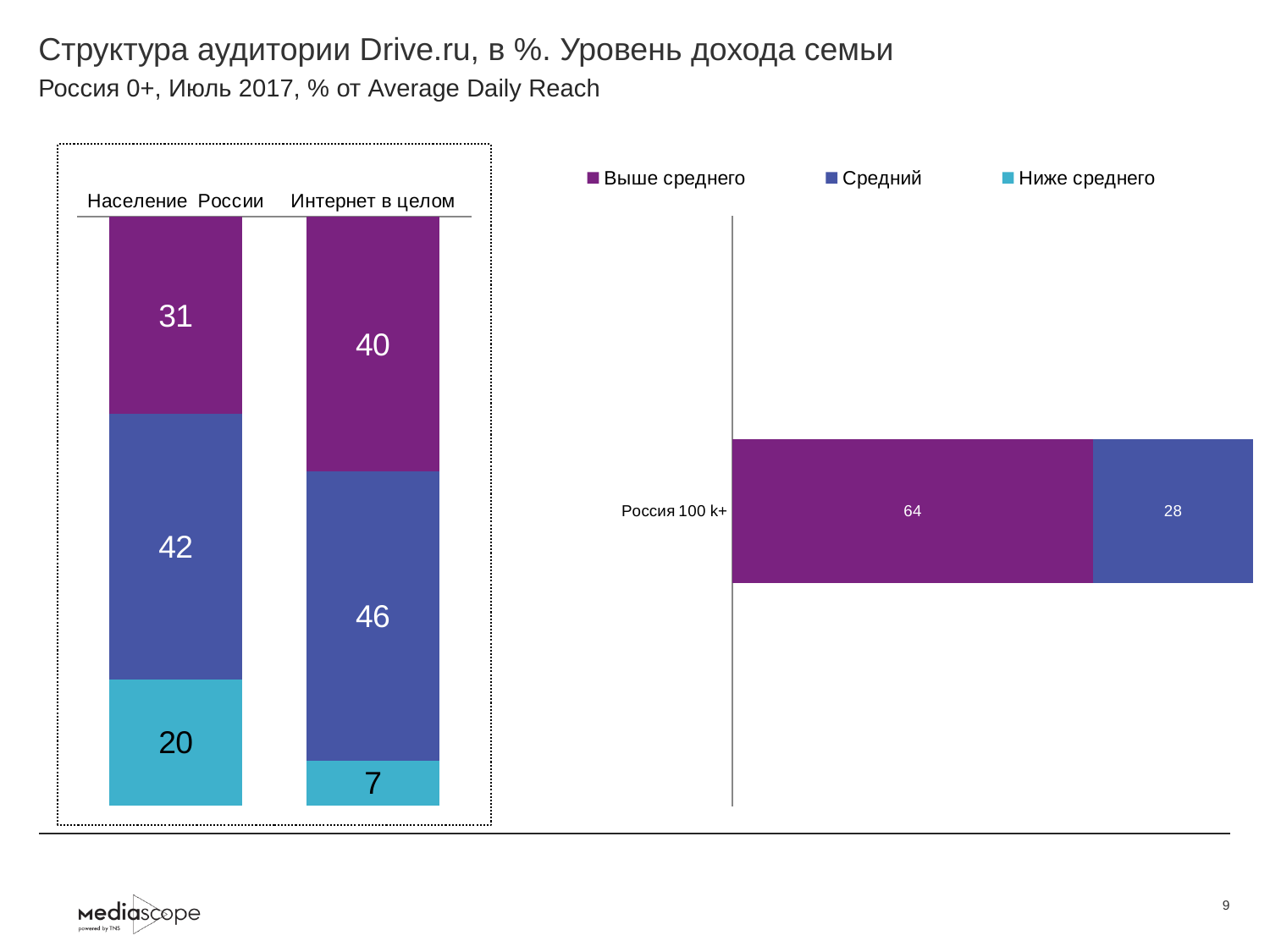
How many categories are shown in the left chart? 2 In the left chart, which category has the larger Выше среднего value, Население России or Интернет в целом? Интернет в целом In the right chart, what is the value of the Средний segment for Россия 100 k+? 28 In the left chart, what is the total of the stacked bar for Интернет в целом? 93 In the left chart, what is the value of the Ниже среднего segment for Интернет в целом? 7 How many series does the legend list? 3 In the left chart, what is the value of the Выше среднего segment for Население России? 31 In the left chart, which segment is the largest for Население России? Средний In the right chart, what is the value of the Выше среднего segment for Россия 100 k+? 64 In the left chart, what is the value of the Средний segment for Интернет в целом? 46 In the left chart, what is the difference between the Ниже среднего values for Население России and Интернет в целом? 13 What kind of chart is the right chart? Stacked bar chart